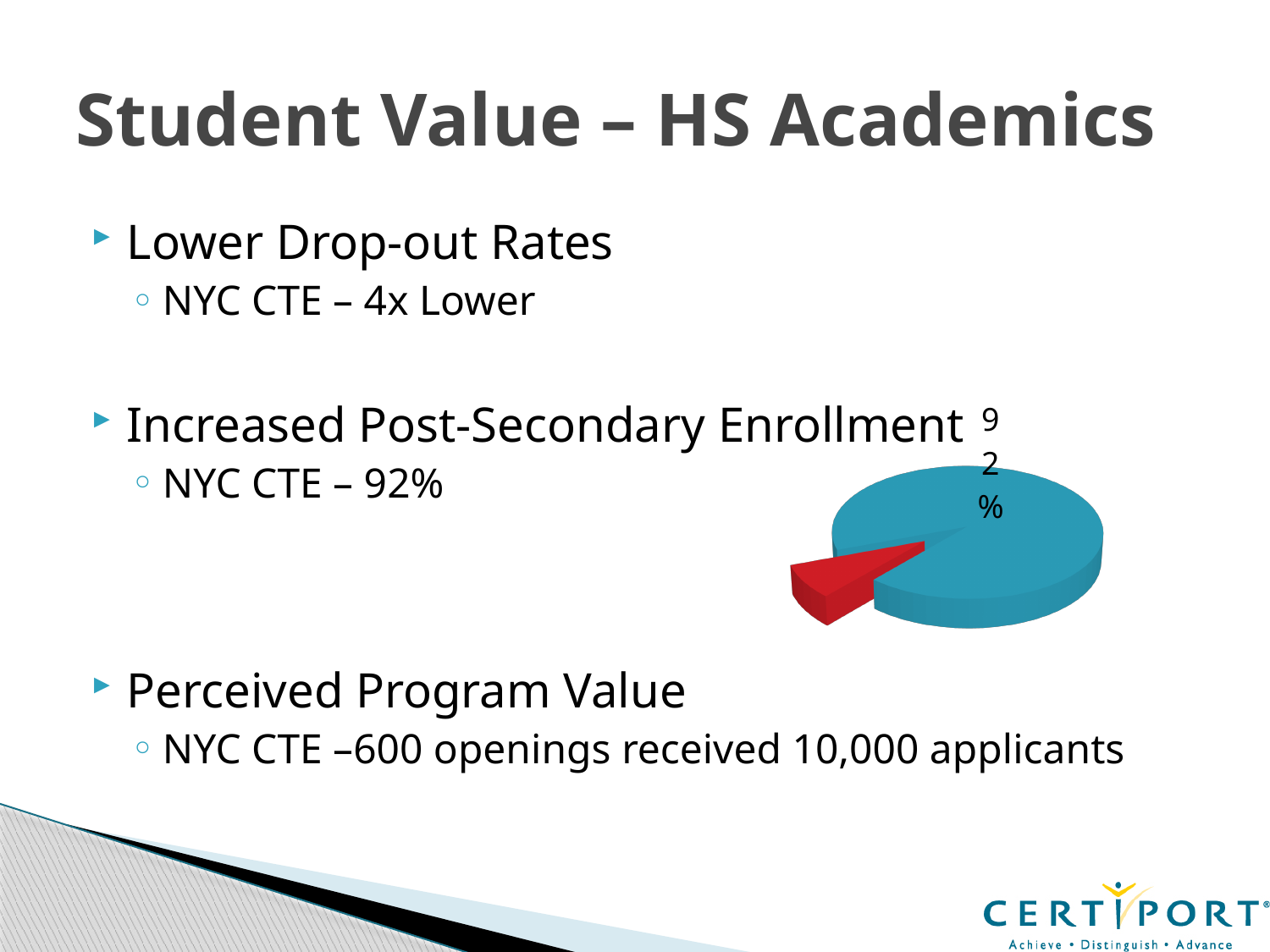
Which slice of the pie chart is larger, the blue one or the red one? blue Does the pie chart display a legend? No Which slice of the pie chart is the smallest? the red slice What kind of chart is shown on the slide? pie chart Is the share of the blue slice greater or less than 50%? greater What percentage is printed on the large blue slice of the pie chart? 92% What colour is the slice that is pulled out from the pie chart? red What share of the pie does the blue slice represent? 92% How many slices does the pie chart have? 2